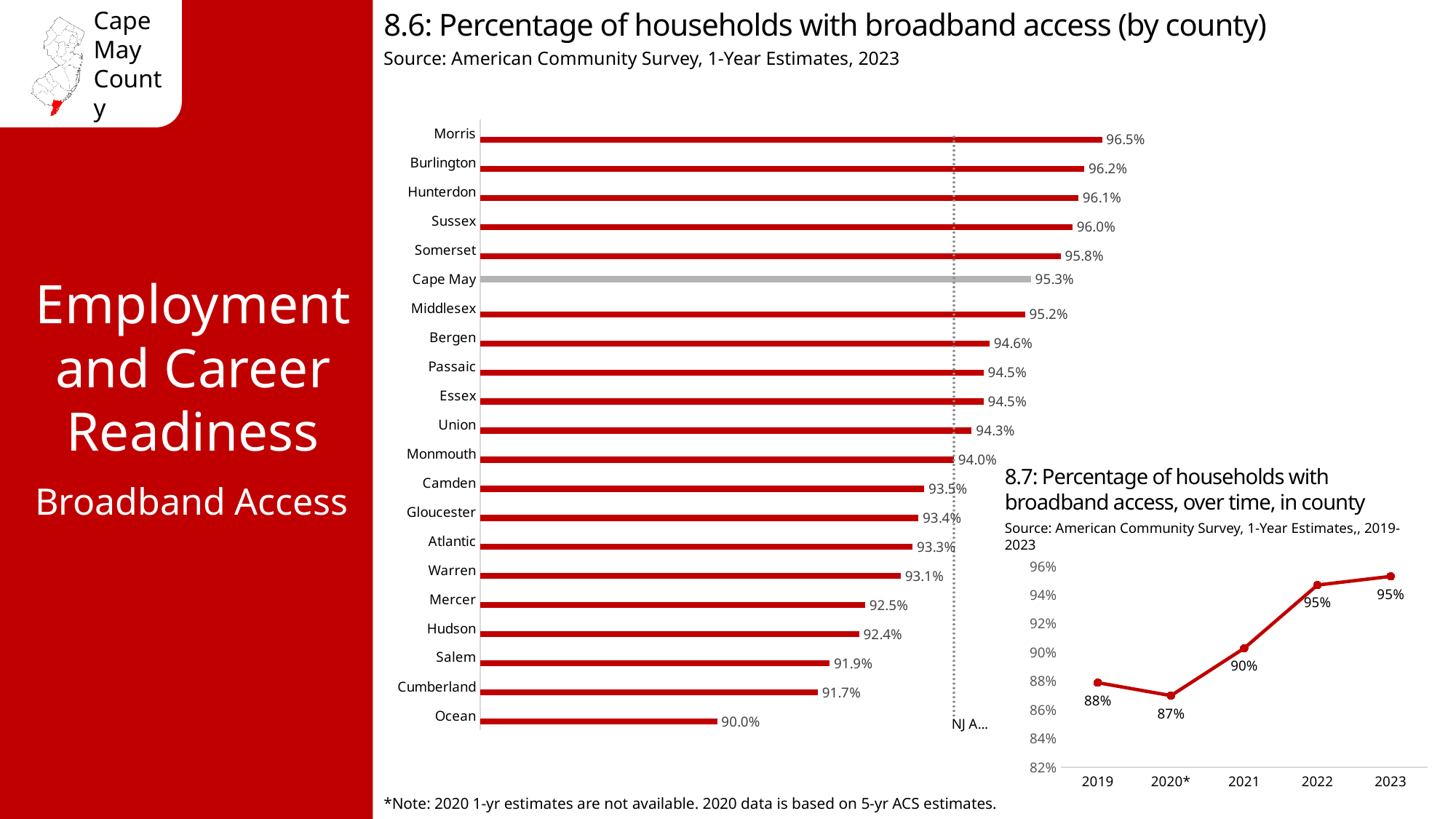
In chart 8.6, which county has the lowest percentage of households with broadband access? Ocean In chart 8.6, which county has a higher value, Bergen or Mercer? Bergen In chart 8.7, what is the difference between the values for 2023 and 2019? 7% In chart 8.6, what is the difference between the values for Morris and Ocean? 6.5% In chart 8.6, which county has the highest percentage of households with broadband access? Morris What kind of chart is chart 8.6? Bar chart In chart 8.6, what is the percentage of households with broadband access in Ocean? 90.0% In chart 8.7, what was the percentage of households with broadband access in 2021? 90% In chart 8.7, how many data points are plotted? 5 In chart 8.6, how many counties are shown? 21 In chart 8.6, what is the percentage of households with broadband access in Cape May? 95.3% In chart 8.7, which year has the lowest percentage of households with broadband access? 2020*